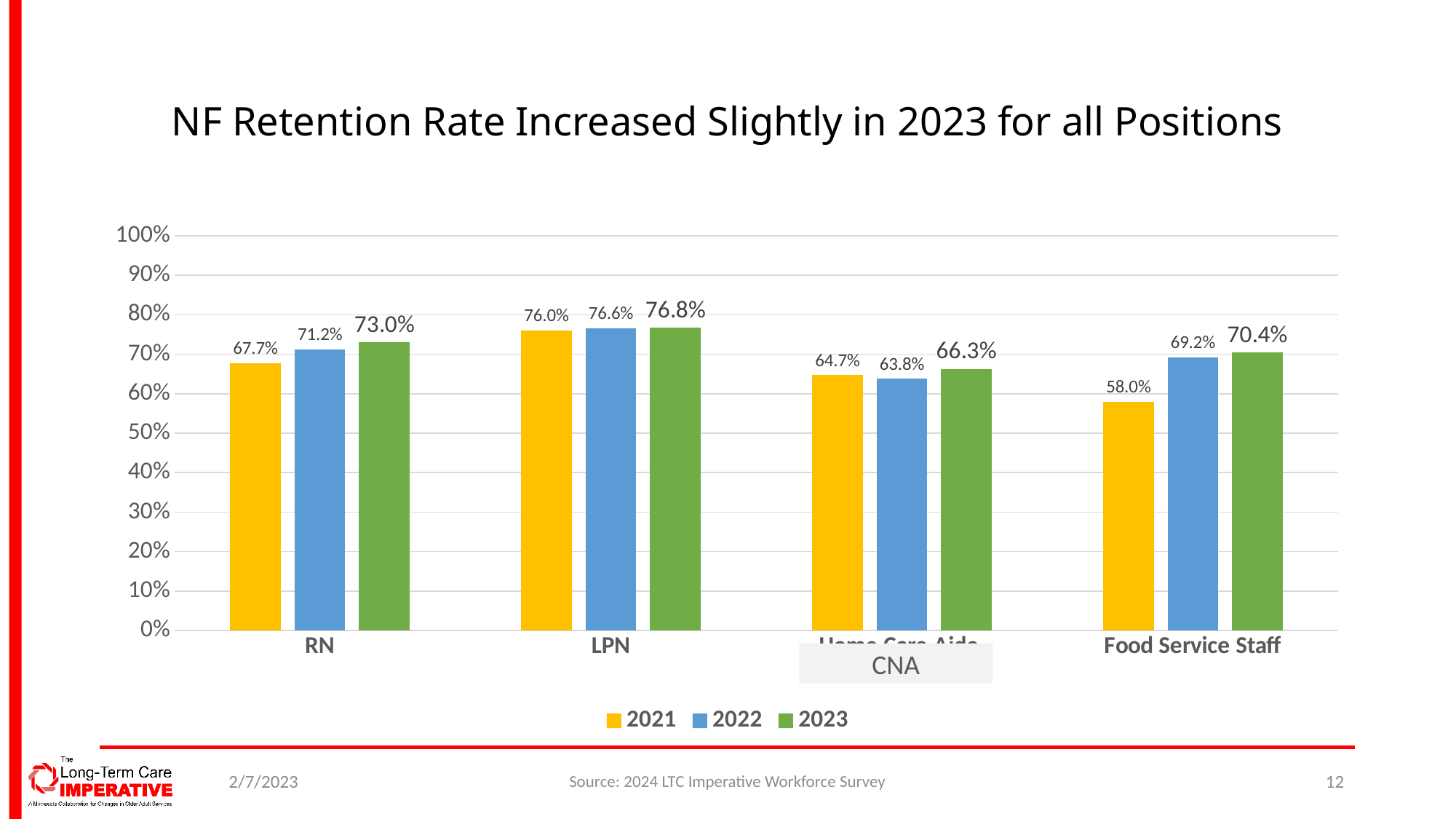
Is the 2022 retention rate for RN greater or less than 80%? less Which position has the lowest 2021 retention rate? Food Service Staff How many series does the legend list? 3 What is the 2023 retention rate for RN? 73.0% Which position has the highest 2023 retention rate? LPN What is the 2022 retention rate for LPN? 76.6% What is the 2021 retention rate for Food Service Staff? 58.0% Which is larger for the CNA category: the 2021 value or the 2022 value? 2021 What is the difference between the 2023 and 2021 retention rates for Food Service Staff? 12.4% What kind of chart is shown on the slide? bar chart Which colour represents the 2023 series in the legend? green How many position categories are shown on the x axis? 4